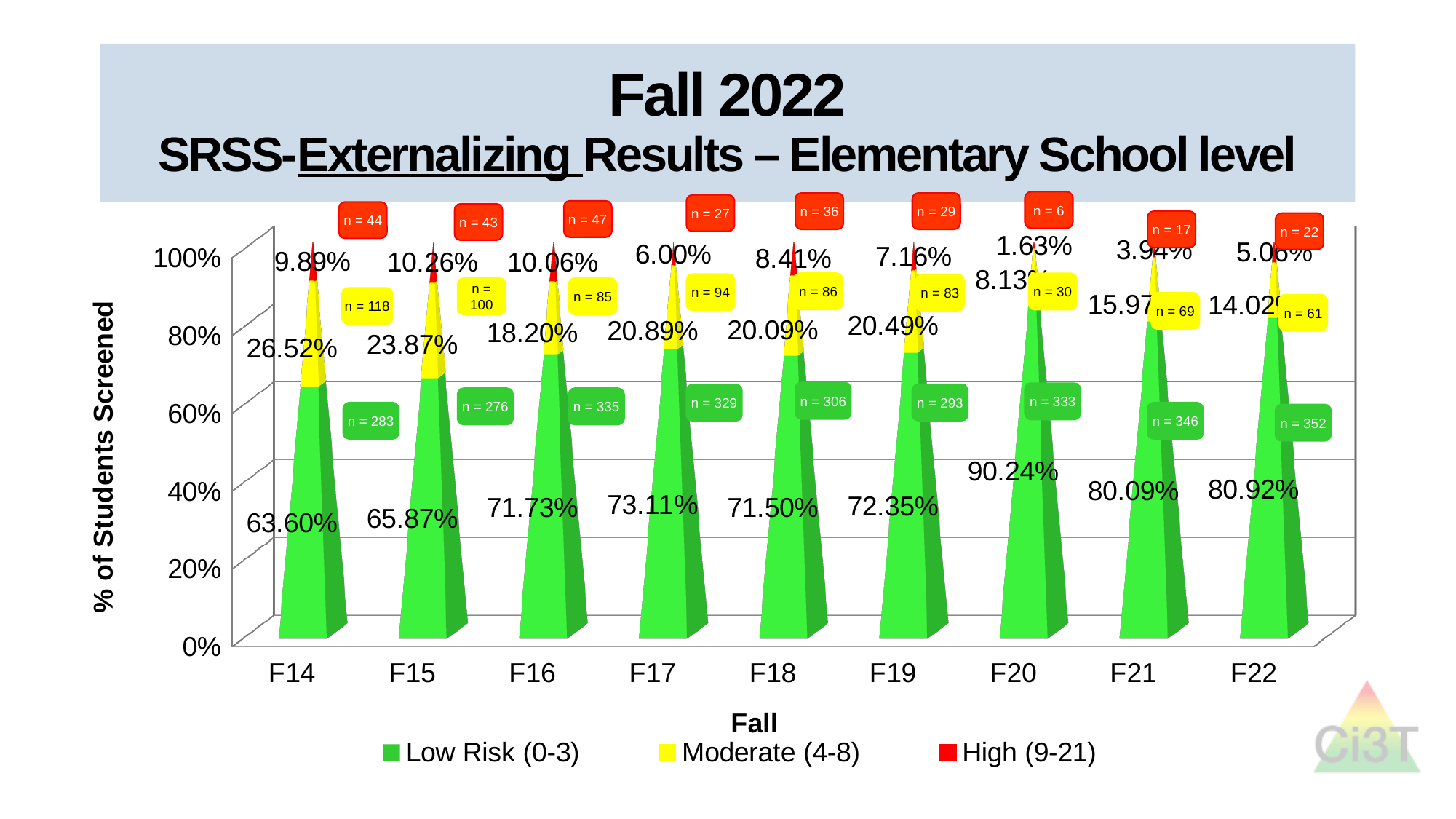
What is the Low Risk (0-3) percentage for F20? 90.24% Which fall has the highest Low Risk (0-3) percentage? F20 Which fall has the lowest Low Risk (0-3) percentage? F14 What kind of chart is shown on the slide? Stacked bar chart How many series does the legend list? 3 How many fall categories are shown on the x axis? 9 What is the High (9-21) percentage for F14? 9.89% What is the Moderate (4-8) percentage for F16? 18.20% Which fall has the lowest High (9-21) percentage? F20 Which has the larger Moderate (4-8) percentage, F14 or F15? F14 What is the n value shown for the Low Risk (0-3) group in F22? n = 352 What is the difference between the Low Risk (0-3) percentages for F22 and F21? 0.83 percentage points